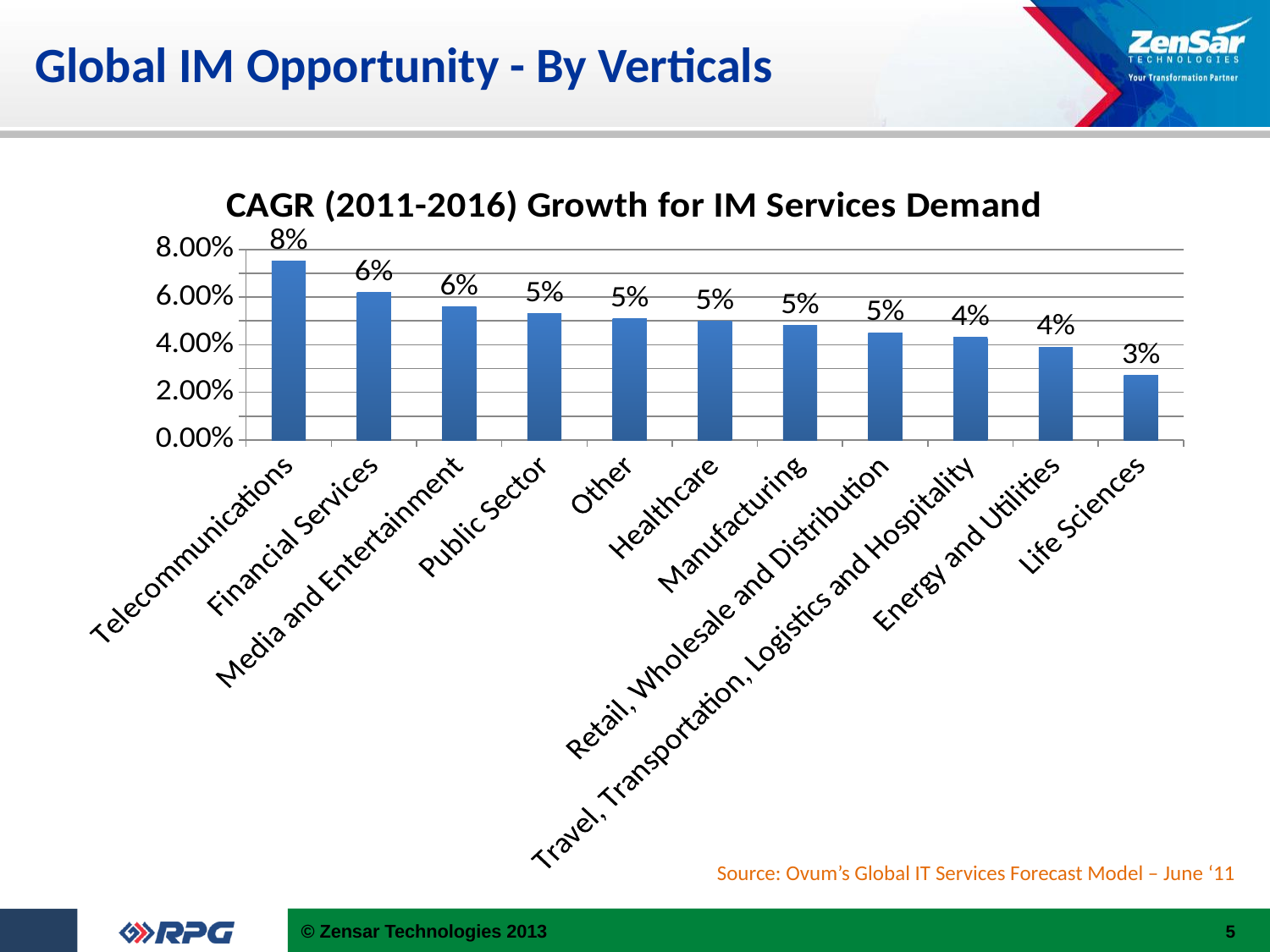
What is the data label shown for Healthcare? 5% What type of chart is shown on the slide? Bar chart What is the data label shown for Financial Services? 6% What is the title of the chart? CAGR (2011-2016) Growth for IM Services Demand Is the value for Life Sciences greater or less than 4.00%? less Which vertical has the lowest CAGR in the chart? Life Sciences Do the values rise or fall moving from left to right along the x axis? Fall How many verticals (categories) are shown in the chart? 11 What is the data label shown for Telecommunications? 8% Is the value for Telecommunications greater or less than 6.00%? greater What is the data label shown for Life Sciences? 3% Which vertical has the highest CAGR in the chart? Telecommunications